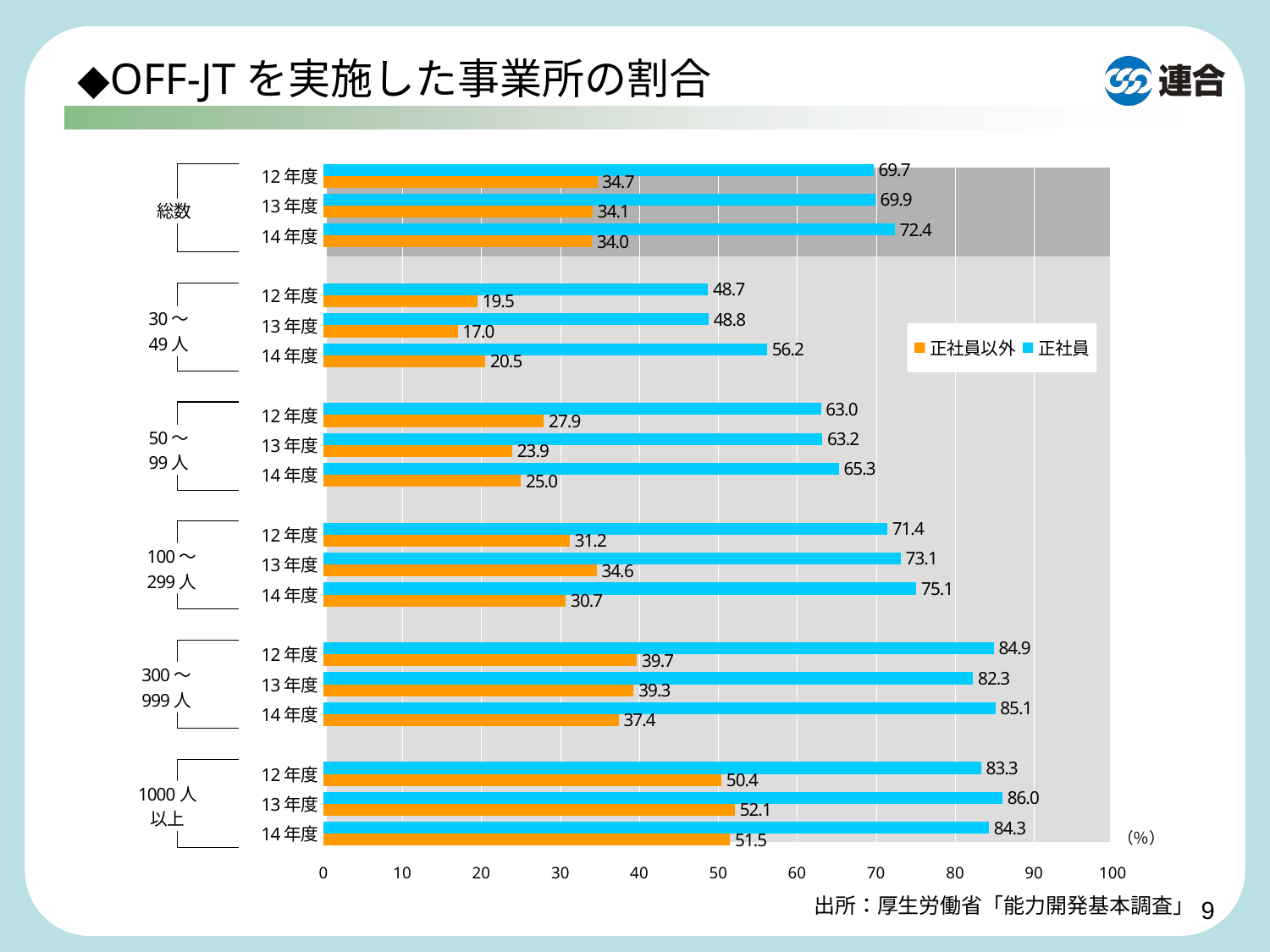
What type of chart is shown on the slide? bar chart Which colour represents 正社員以外 in the legend? orange Do the 正社員 values in the 100～299人 group rise or fall from 12年度 to 14年度? rise What is the value for 正社員以外 in 1000人以上 for 13年度? 52.1 What is the value for 正社員 in 総数 for 14年度? 72.4 How many series does the legend list? 2 What is the difference between the 正社員 and 正社員以外 values in 300～999人 for 12年度? 45.2 What is the value for 正社員以外 in 30～49人 for 13年度? 17.0 Which year has the highest 正社員 value in the 1000人以上 group? 13年度 Which year has the lowest 正社員以外 value in the 50～99人 group? 13年度 Which is larger: the 正社員 value for 100～299人 in 14年度 or the 正社員 value for 50～99人 in 14年度? 100～299人 in 14年度 How many size groups (categories) are shown on the vertical axis? 6